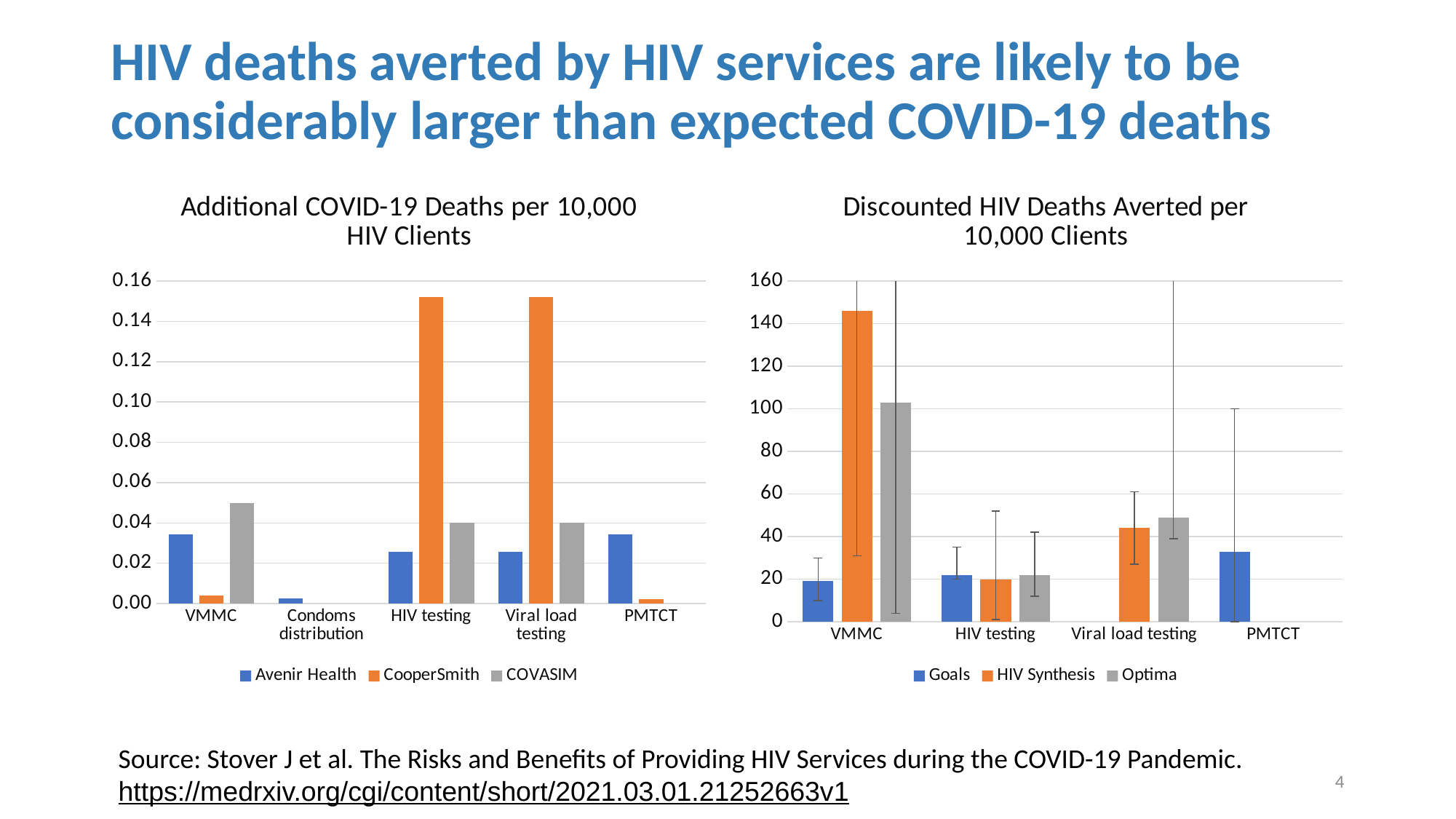
In the 'Additional COVID-19 Deaths per 10,000 HIV Clients' chart, is the Avenir Health value for VMMC greater or less than 0.02? greater In the 'Discounted HIV Deaths Averted per 10,000 Clients' chart, which is larger for Viral load testing: HIV Synthesis or Optima? Optima In the 'Additional COVID-19 Deaths per 10,000 HIV Clients' chart, which is larger for VMMC: CooperSmith or COVASIM? COVASIM Which series are listed in the legend of the 'Additional COVID-19 Deaths per 10,000 HIV Clients' chart? Avenir Health, CooperSmith, COVASIM In the 'Discounted HIV Deaths Averted per 10,000 Clients' chart, is the HIV Synthesis value for VMMC greater or less than 140? greater In the 'Additional COVID-19 Deaths per 10,000 HIV Clients' chart, is the CooperSmith value for HIV testing greater or less than 0.14? greater In the 'Discounted HIV Deaths Averted per 10,000 Clients' chart, which series has the highest bar for VMMC? HIV Synthesis How many series does the legend of the 'Discounted HIV Deaths Averted per 10,000 Clients' chart list? 3 What type of chart is the 'Additional COVID-19 Deaths per 10,000 HIV Clients' chart? bar chart How many categories are shown on the x axis of the 'Additional COVID-19 Deaths per 10,000 HIV Clients' chart? 5